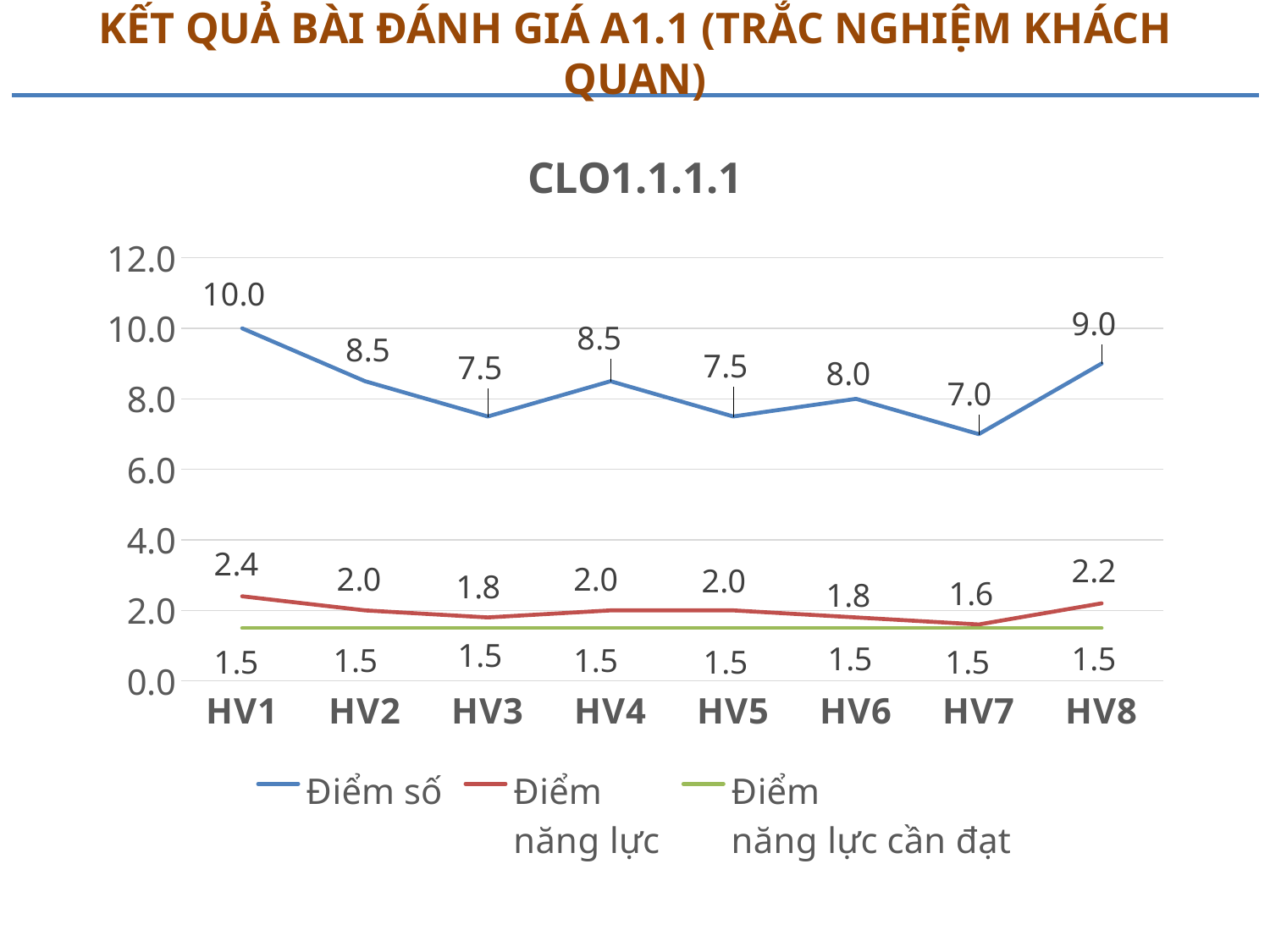
What is the Điểm năng lực cần đạt value for HV4? 1.5 Is the Điểm số value for HV4 greater or less than 8.0? greater Which category has the highest Điểm năng lực value? HV1 What is the title of the chart? CLO1.1.1.1 Which category has the lowest Điểm số value? HV7 What is the Điểm số value for HV1? 10.0 What is the Điểm năng lực value for HV8? 2.2 Which is larger, the Điểm số value for HV2 or for HV8? HV8 How many series does the legend list? 3 What kind of chart is shown on the slide? line chart How many categories are shown on the x axis? 8 What is the difference between the Điểm số values for HV1 and HV7? 3.0